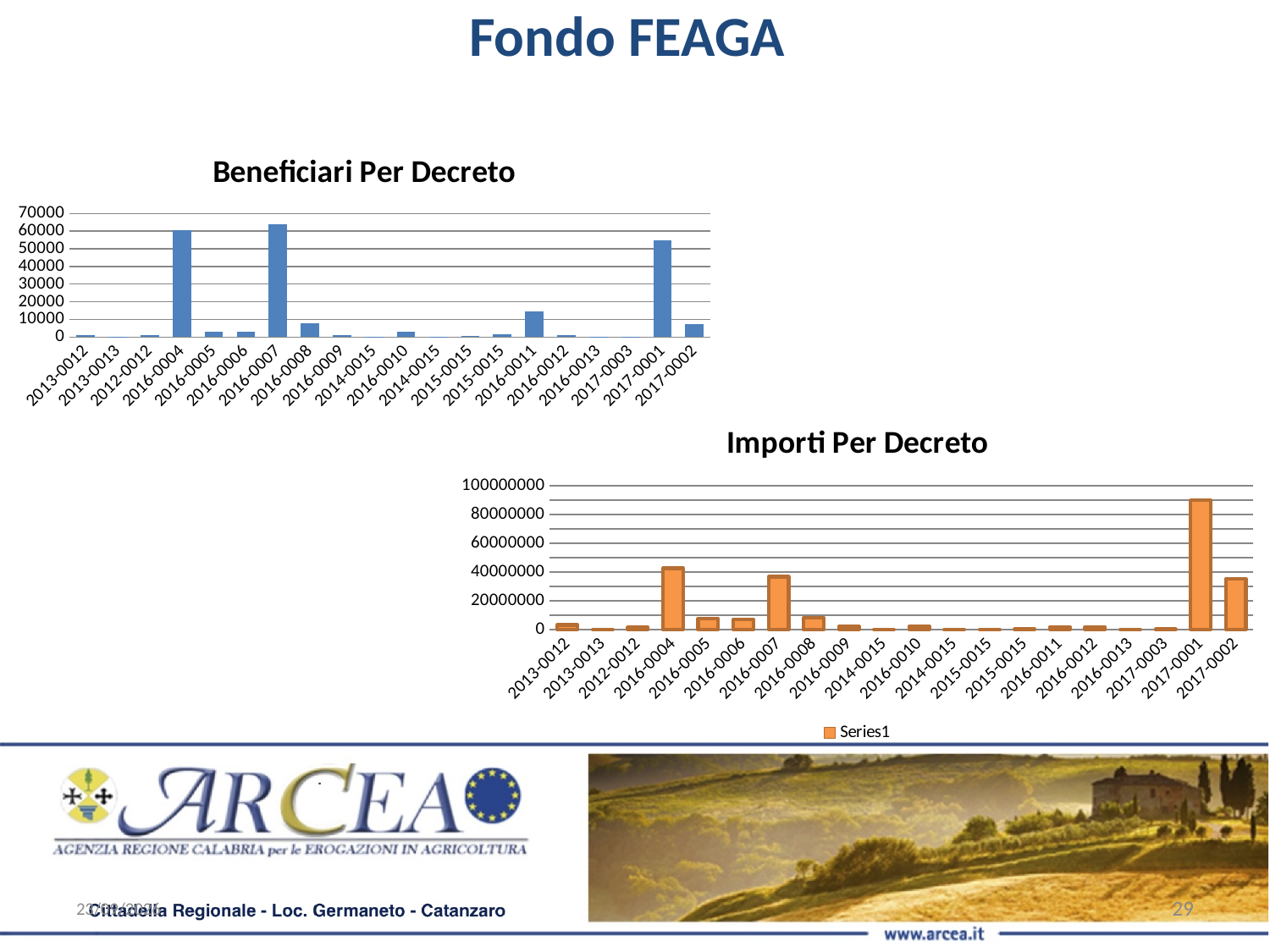
In the 'Beneficiari Per Decreto' chart, which decree has the highest number of beneficiaries? 2016-0007 What kind of chart is the 'Beneficiari Per Decreto' chart? bar chart In the 'Importi Per Decreto' chart, is the value for 2017-0001 greater or less than 80000000? greater In the 'Importi Per Decreto' chart, which is larger, the value for 2016-0004 or the value for 2017-0002? 2016-0004 What is the legend entry shown under the 'Importi Per Decreto' chart? Series1 In the 'Beneficiari Per Decreto' chart, is the value for 2016-0008 greater or less than 10000? less In the 'Beneficiari Per Decreto' chart, is the value for 2017-0001 greater or less than 60000? less How many series does the legend of the 'Importi Per Decreto' chart list? 1 In the 'Importi Per Decreto' chart, which decree has the highest amount? 2017-0001